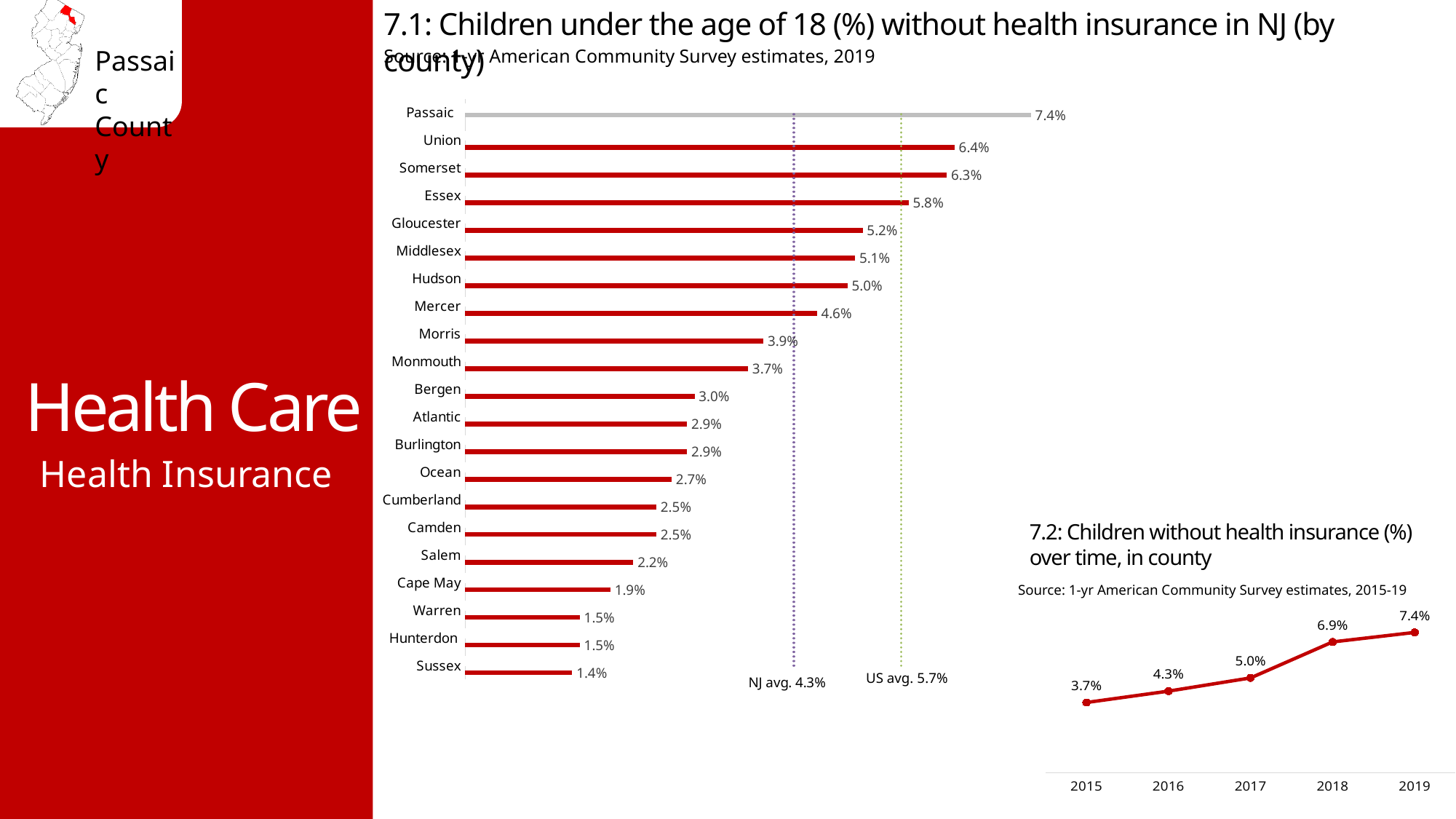
In chart 7.1, which county has the lowest percentage of children without health insurance? Sussex In chart 7.1, which county has a higher value, Essex or Gloucester? Essex In chart 7.2, what is the difference between the 2019 and 2015 values? 3.7% In chart 7.1, what is the value for Hudson? 5.0% In chart 7.2 (children without health insurance over time), what is the value for 2017? 5.0% In chart 7.1, what is the NJ average shown by the dotted reference line? 4.3% In chart 7.1 (children under 18 without health insurance by county), what is the value for Passaic? 7.4% In chart 7.1, how many counties are plotted? 21 In chart 7.2, does the percentage of children without health insurance rise or fall from 2015 to 2019? Rise In chart 7.1, what is the difference between the values for Passaic and Union? 1.0% What kind of chart is chart 7.1? Bar chart In chart 7.1, which county has the highest percentage of children without health insurance? Passaic